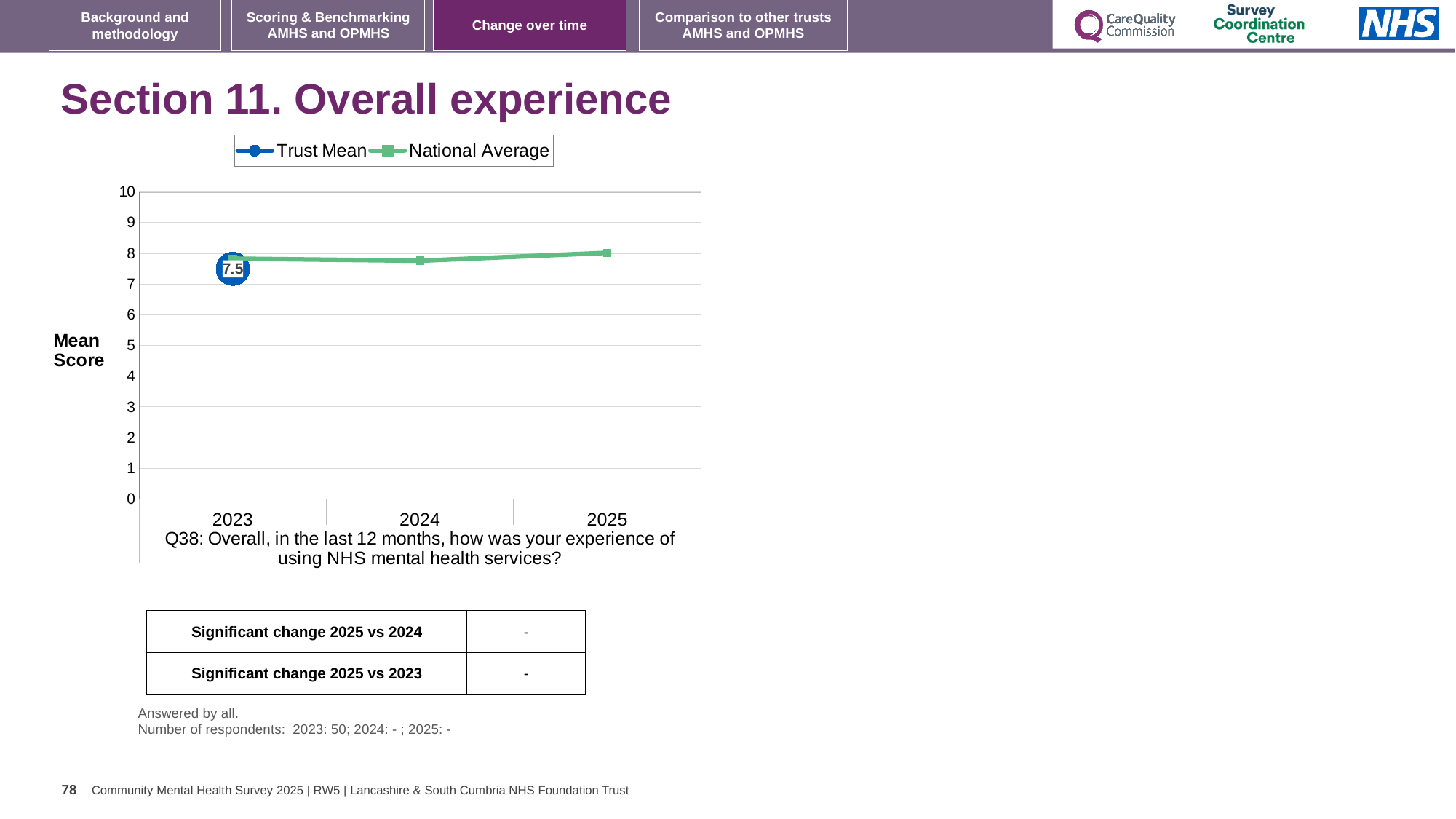
Does the National Average rise or fall from 2024 to 2025? rise What kind of chart is shown on the slide? line chart Is the National Average value for 2025 greater or less than 9? less How many series does the legend list? 2 What is the label on the y axis? Mean Score Is the National Average value for 2024 greater or less than 5? greater For how many years is a Trust Mean value plotted? 1 Which series is shown in green? National Average Is the Trust Mean value for 2023 greater or less than 8? less How many years are shown on the x axis? 3 What is the Trust Mean score for 2023? 7.5